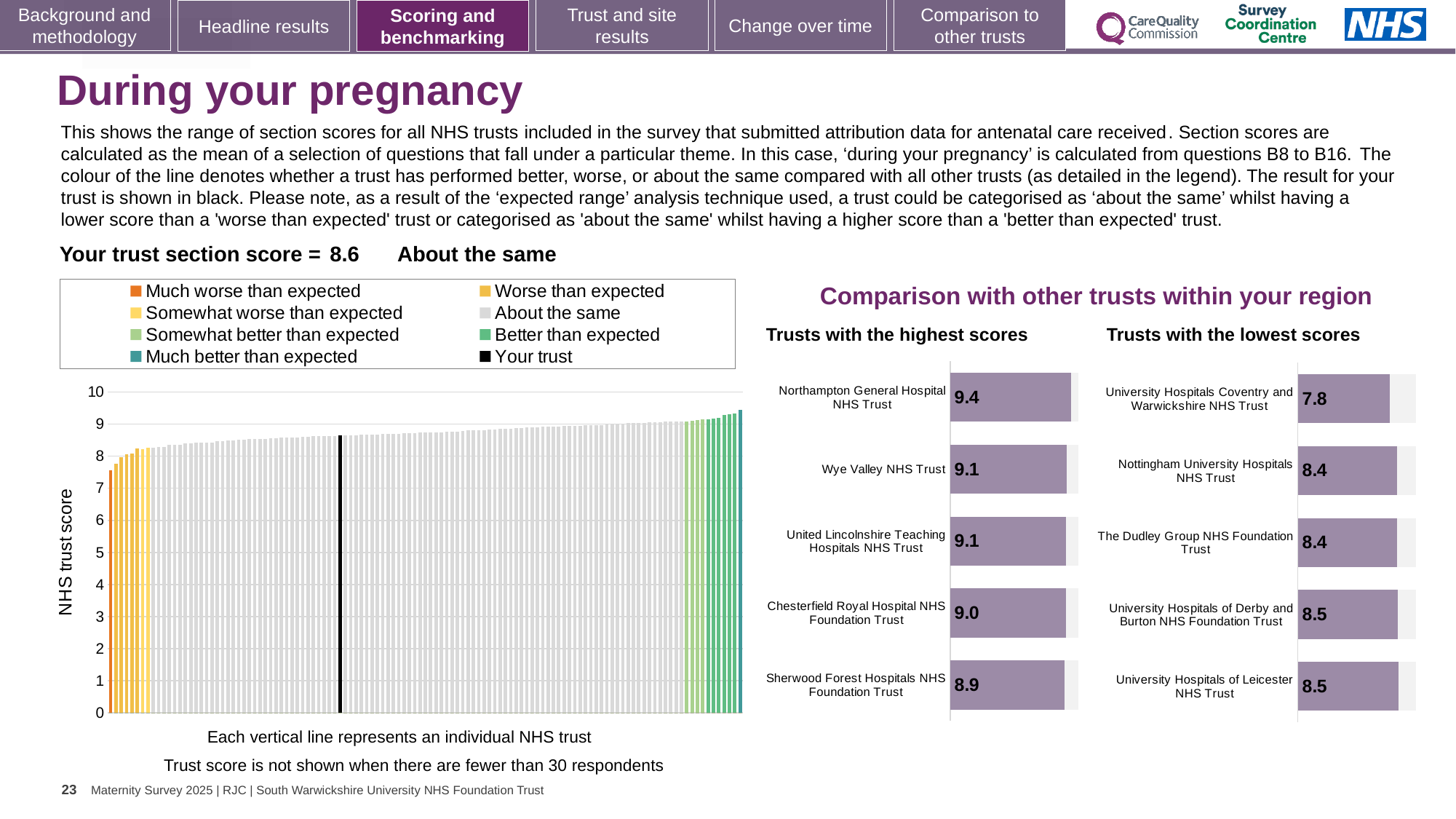
How many entries does the legend of the main 'NHS trust score' chart list? 8 In the 'Trusts with the lowest scores' chart, what is the score for University Hospitals of Leicester NHS Trust? 8.5 In the 'Trusts with the highest scores' chart, what is the score for Northampton General Hospital NHS Trust? 9.4 In the 'Trusts with the highest scores' chart, which trust has the highest score? Northampton General Hospital NHS Trust In the 'Trusts with the highest scores' chart, what is the difference between the scores of Northampton General Hospital NHS Trust and Chesterfield Royal Hospital NHS Foundation Trust? 0.4 What type of chart is the main chart on the left with the 'NHS trust score' axis? Bar chart How many trusts are shown in the 'Trusts with the lowest scores' chart? 5 In the 'Trusts with the lowest scores' chart, what is the score for University Hospitals Coventry and Warwickshire NHS Trust? 7.8 In the 'Trusts with the lowest scores' chart, which trust has the lowest score? University Hospitals Coventry and Warwickshire NHS Trust In the 'Trusts with the highest scores' chart, what is the score for Sherwood Forest Hospitals NHS Foundation Trust? 8.9 In the 'Trusts with the lowest scores' chart, what is the difference between the scores of Nottingham University Hospitals NHS Trust and University Hospitals Coventry and Warwickshire NHS Trust? 0.6 Which has a higher score: Wye Valley NHS Trust in the 'Trusts with the highest scores' chart or The Dudley Group NHS Foundation Trust in the 'Trusts with the lowest scores' chart? Wye Valley NHS Trust